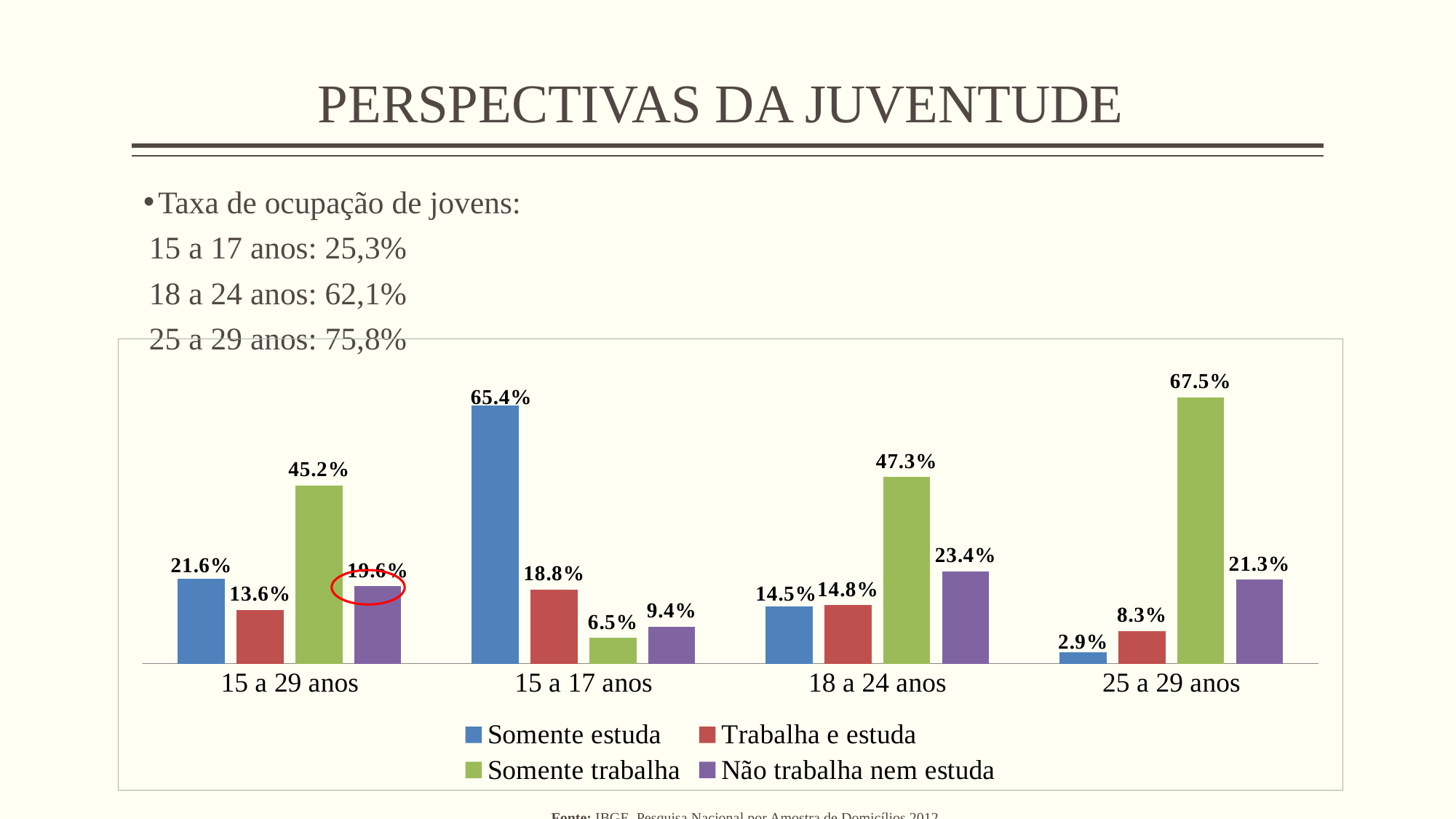
Which series has the lowest value in the '25 a 29 anos' group? Somente estuda What is the value for 'Não trabalha nem estuda' in the '15 a 17 anos' group? 9.4% What is the difference between 'Somente trabalha' and 'Somente estuda' in the '15 a 29 anos' group? 23.6% Which series has the highest value in the '18 a 24 anos' group? Somente trabalha Which legend entry is shown in green? Somente trabalha How many series does the legend list? 4 What kind of chart is shown on the slide? bar chart Which is larger in the '15 a 17 anos' group: 'Trabalha e estuda' or 'Somente trabalha'? Trabalha e estuda What is the value for 'Somente trabalha' in the '25 a 29 anos' group? 67.5% How many age-group categories are shown on the x axis? 4 What is the value for 'Somente estuda' in the '15 a 17 anos' group? 65.4% What is the value for 'Trabalha e estuda' in the '18 a 24 anos' group? 14.8%